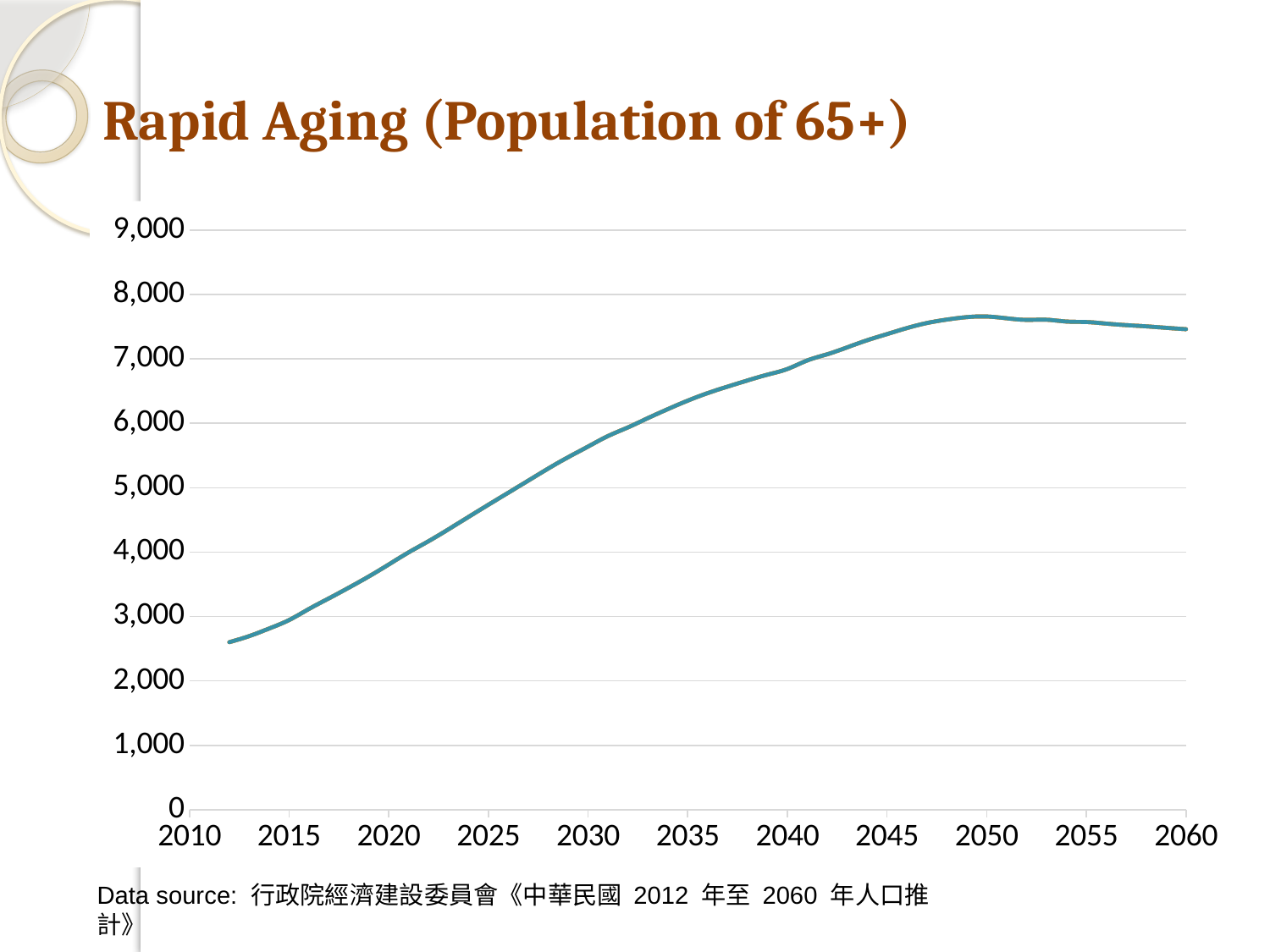
What is the title of the slide containing the chart? Rapid Aging (Population of 65+) Is the value for 2050 greater or less than 7,000? greater Does the line rise or fall between 2050 and 2060? fall Which is larger, the value for 2030 or the value for 2050? 2050 Is the value for 2020 greater or less than 4,000? less Is the value for 2030 greater or less than 5,000? greater Does the line generally rise or fall between 2010 and 2045? rise What kind of chart is shown on the slide? line chart